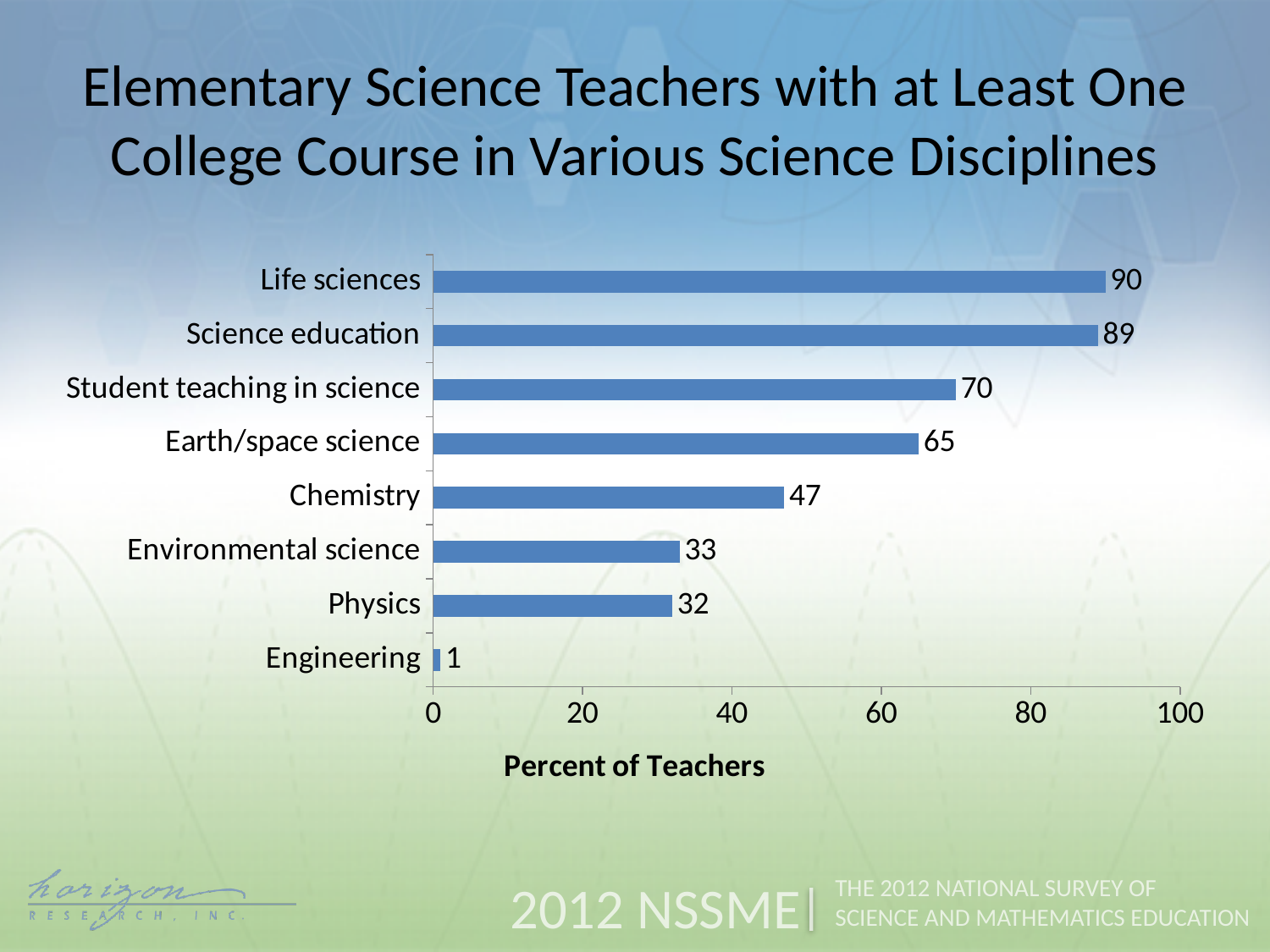
What is the difference between the values for Life sciences and Physics? 58 Which discipline has the highest percent of teachers? Life sciences Which has a larger value, Chemistry or Environmental science? Chemistry What percent of elementary science teachers have at least one college course in Life sciences? 90 What is the label of the horizontal axis? Percent of Teachers What kind of chart is shown on the slide? bar chart How many science disciplines are shown in the chart? 8 What is the difference between the values for Student teaching in science and Earth/space science? 5 Is the value for Earth/space science greater or less than 60? greater What is the value shown for Chemistry? 47 What is the value shown for Engineering? 1 Which discipline has the lowest percent of teachers? Engineering